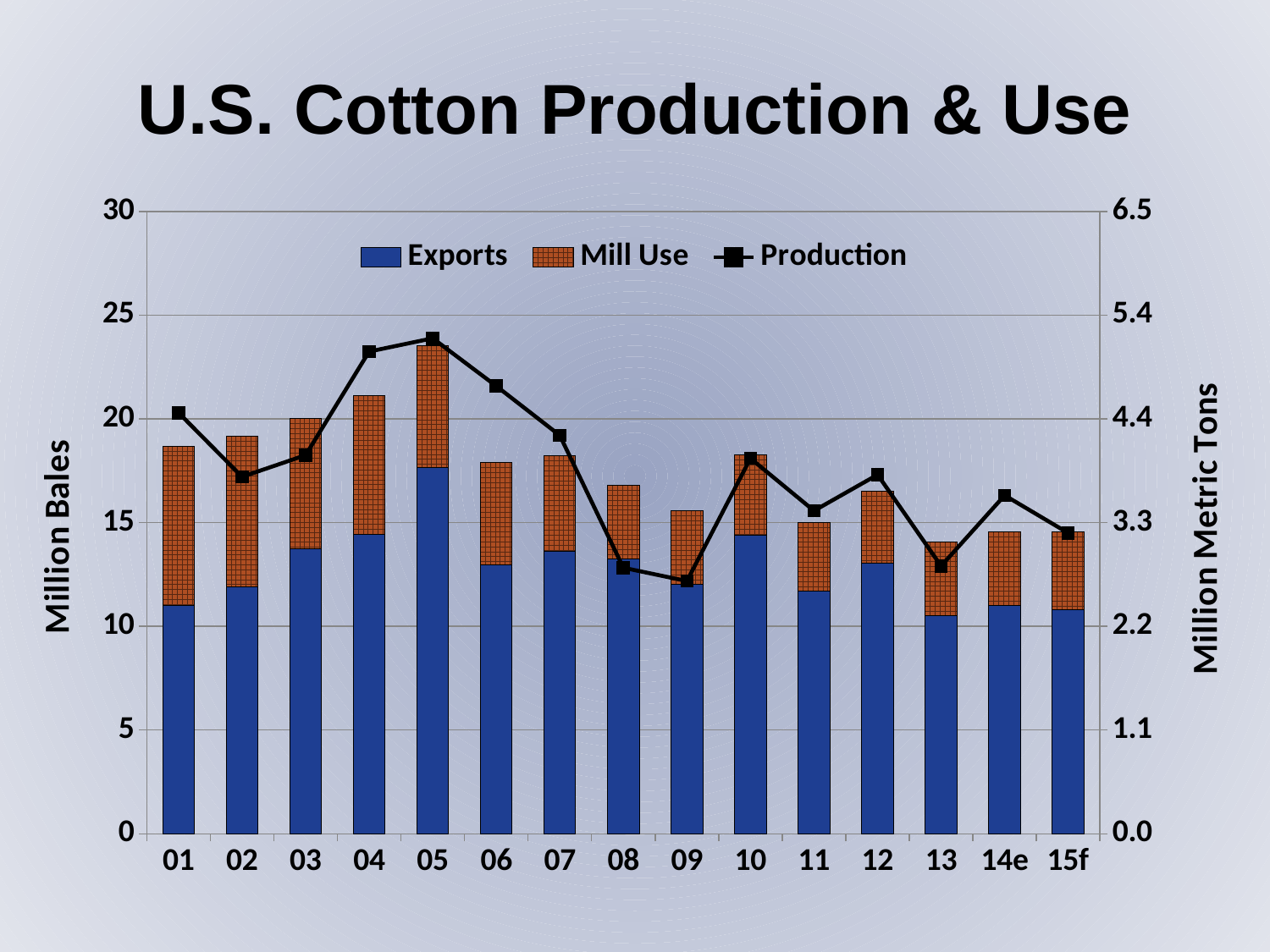
Which year has the higher Production value, 04 or 08? 04 Is the Exports value for 05 greater or less than 15 million bales? greater Which year has the tallest stacked bar (Exports plus Mill Use)? 05 How many years are shown along the x axis? 15 Does the Production line rise or fall from 05 to 09? fall What kind of chart is shown on the slide? A combination chart with stacked bars and a line How many series does the legend list? 3 Is the total stacked bar for 13 greater or less than 15 million bales? less Is the Production value for 09 greater or less than 3.3 million metric tons? less In which year does the Production line reach its highest point? 05 What is the label of the right-hand vertical axis? Million Metric Tons In which year does the Production line reach its lowest point? 09